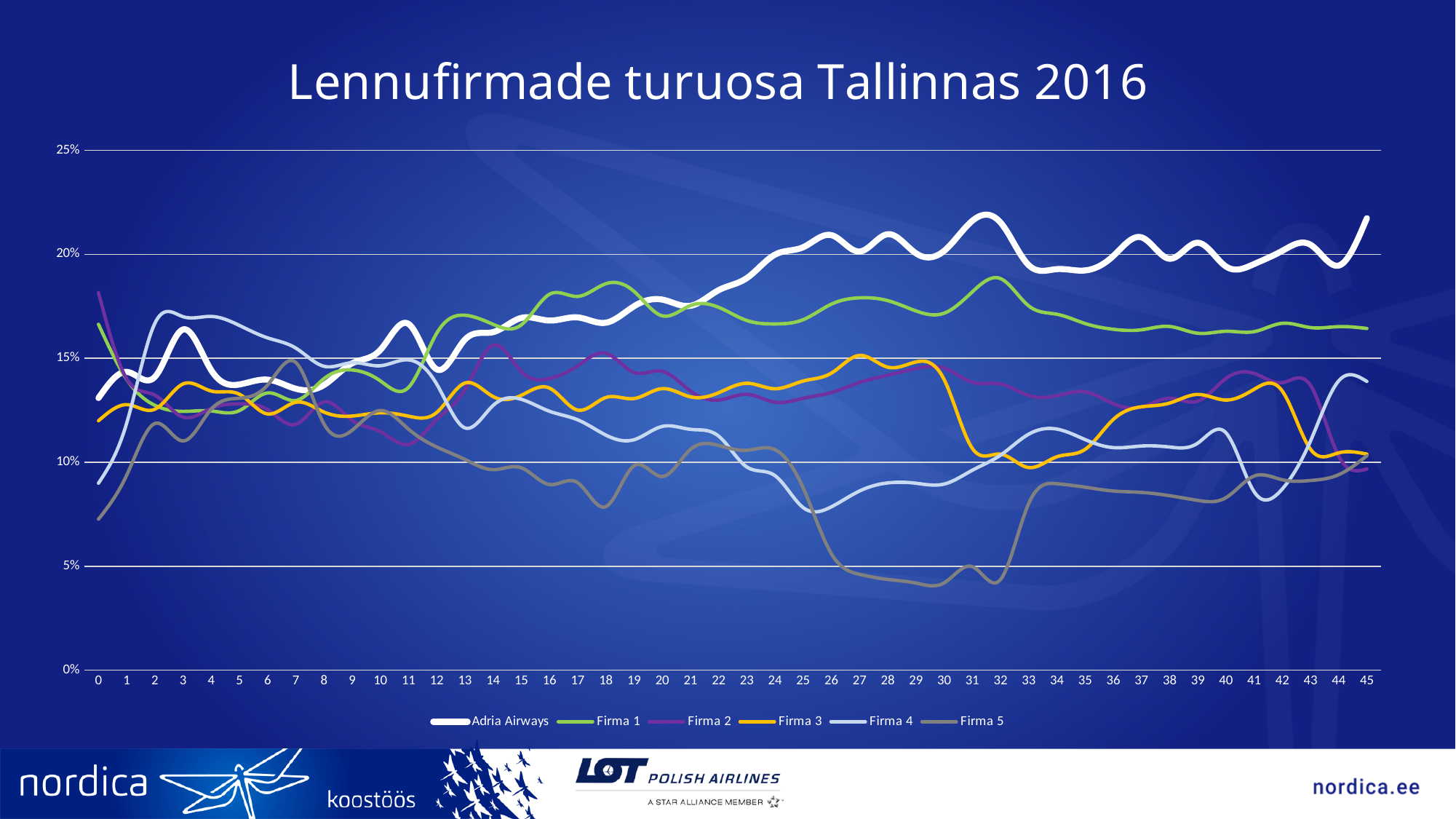
Which series is drawn with the thick white line? Adria Airways Is the value for Firma 5 at point 27 greater or less than 5%? less At point 27, which is larger: Firma 4 or Firma 5? Firma 4 Which series has the lowest value at point 27? Firma 5 Is the value for Firma 4 at point 26 greater or less than 10%? less What kind of chart is shown on the slide? line chart How many points are there along the x axis (from 0 to 45)? 46 How many series does the legend list? 6 What is the title of the chart? Lennufirmade turuosa Tallinnas 2016 Is the value for Adria Airways at point 31 greater or less than 20%? greater Which series has the highest value at point 45? Adria Airways Does the Adria Airways line rise or fall overall from point 0 to point 45? rise